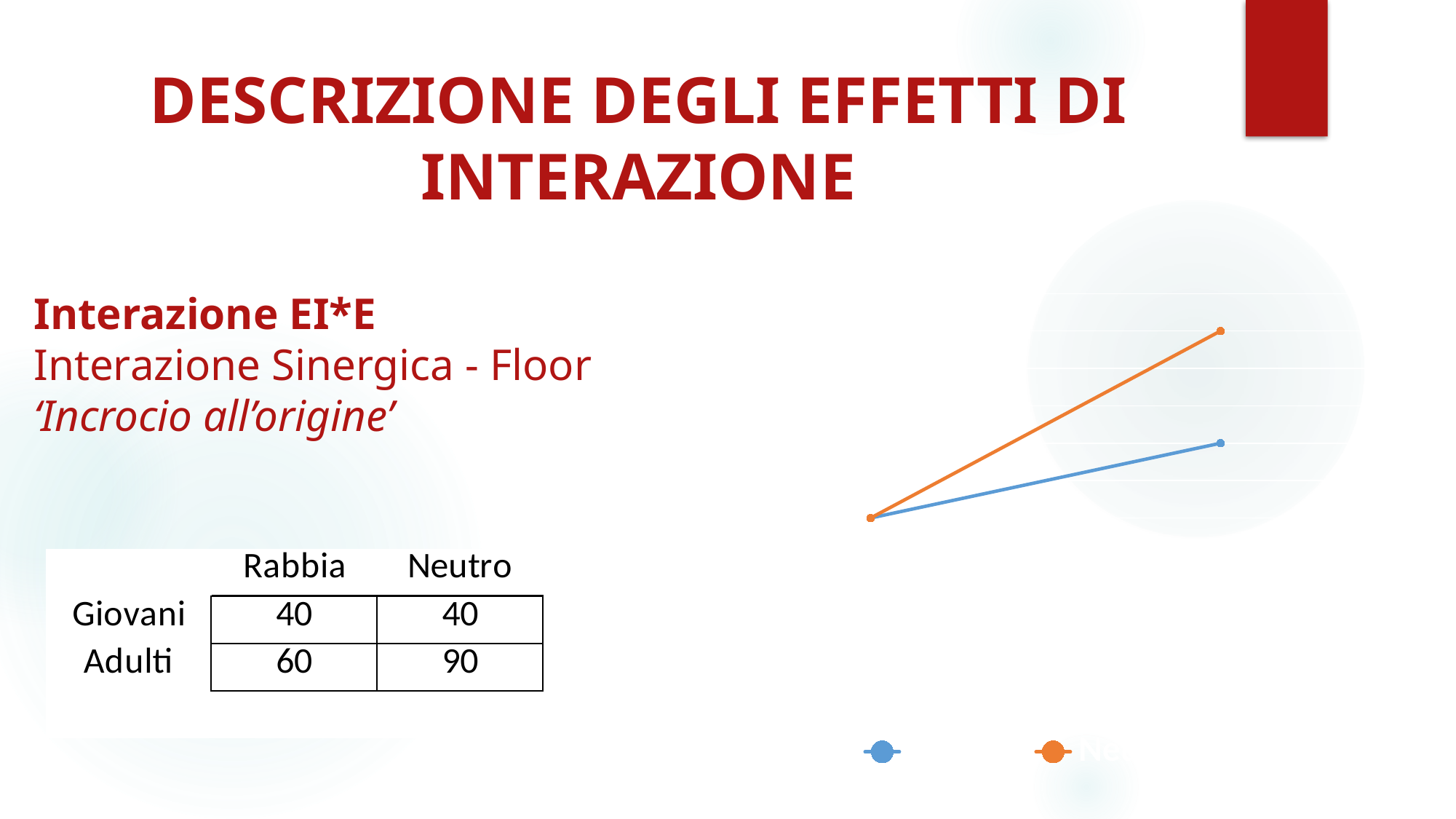
What two colours are used for the lines in the chart? blue and orange How many points are plotted on each line in the chart? 2 Which line in the chart rises more steeply, the blue one or the orange one? orange What kind of chart is shown on the right of the slide? line chart Do the lines in the chart rise or fall from left to right? rise At the right end of the chart, which line is higher, the orange line or the blue line? orange How many series does the chart's legend list? 2 Do the two lines in the chart start from the same point on the left? yes